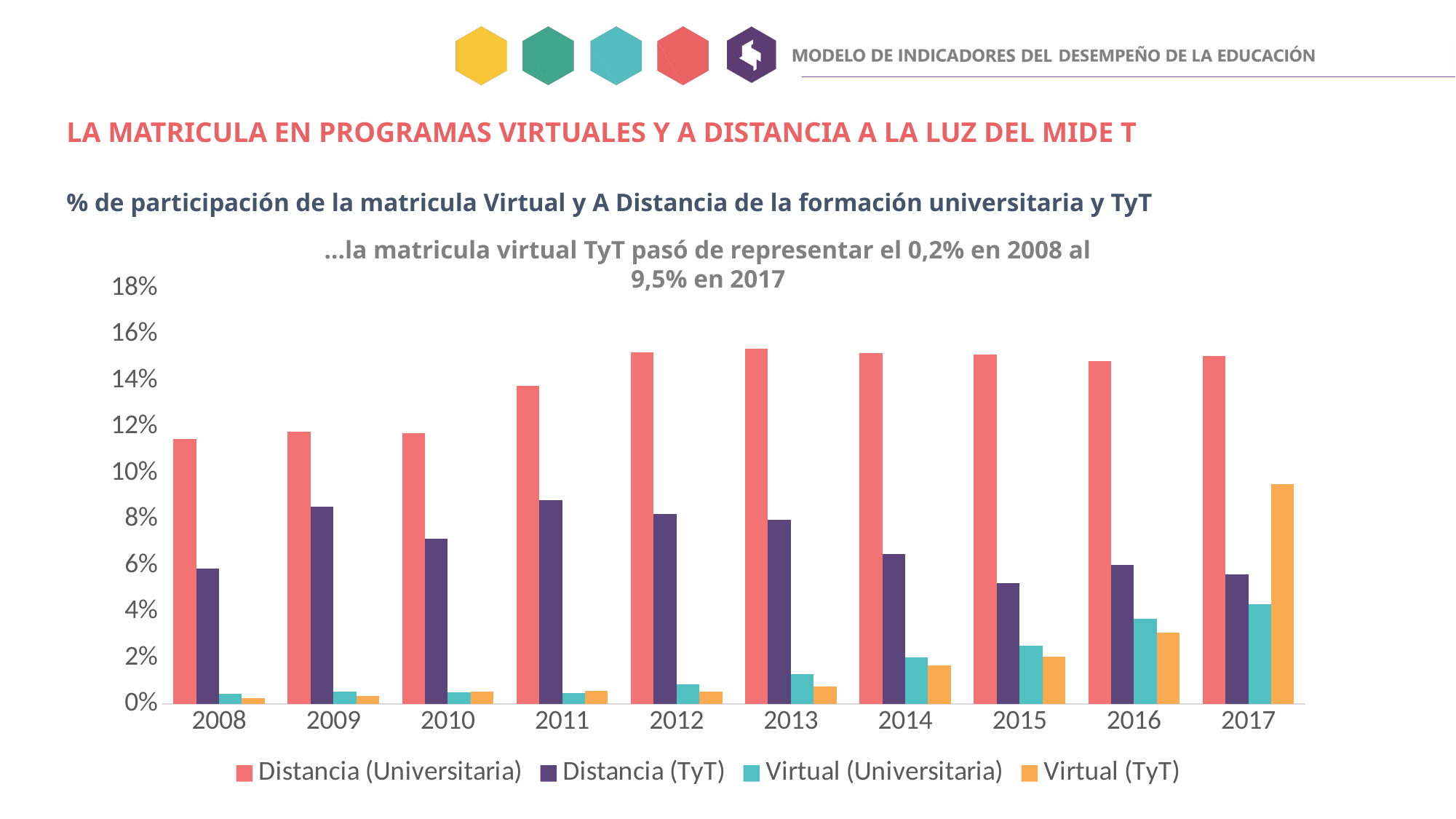
Does the Virtual (TyT) series generally rise or fall from 2008 to 2017? rise According to the slide, what share did the Virtual (TyT) matricula represent in 2008? 0,2% Is the value for Distancia (Universitaria) in 2008 greater or less than 12%? less Is the value for Virtual (Universitaria) in 2016 greater or less than 2%? greater What colour represents the Virtual (TyT) series in the chart? orange According to the slide, what share did the Virtual (TyT) matricula represent in 2017? 9,5% In 2017, which is larger: Virtual (TyT) or Distancia (TyT)? Virtual (TyT) Is the value for Distancia (Universitaria) in 2011 greater or less than 12%? greater How many years are shown on the x axis of the chart? 10 In which year is the Virtual (TyT) value highest? 2017 How many series does the chart's legend list? 4 What kind of chart is shown on the slide? bar chart